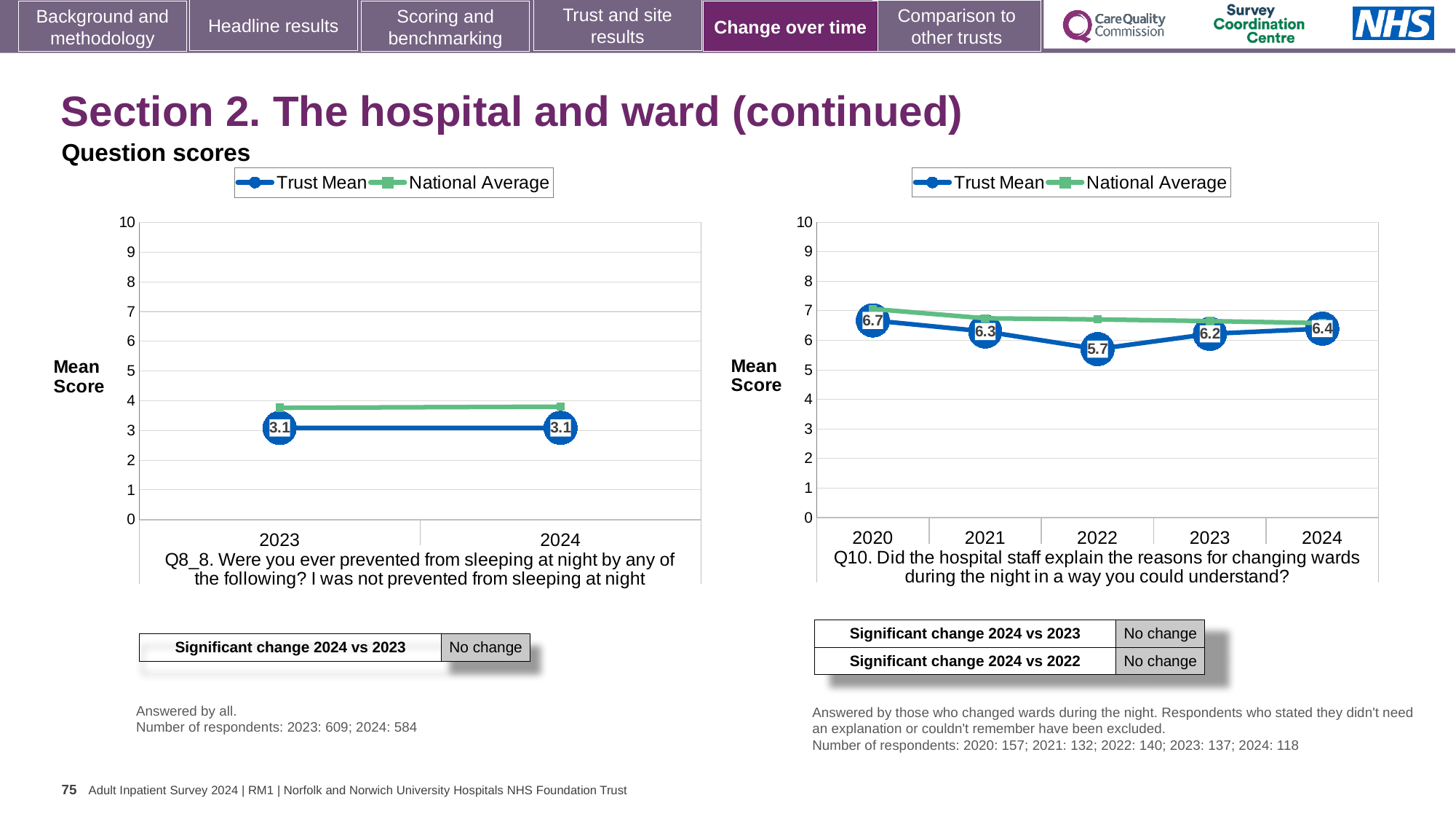
In the Q10 chart on the right, what is the difference between the Trust Mean scores for 2020 and 2022? 1.0 How many series does the legend of the Q8_8 chart on the left list? 2 In the Q8_8 chart on the left, is the National Average value for 2024 greater or less than 3? greater How many years are shown on the x axis of the Q10 chart on the right? 5 In the Q8_8 chart on the left, what is the Trust Mean score for 2023? 3.1 In the Q10 chart on the right, what is the Trust Mean score for 2022? 5.7 In the Q8_8 chart on the left, what is the Trust Mean score for 2024? 3.1 In the Q10 chart on the right, what is the Trust Mean score for 2024? 6.4 In the Q10 chart on the right, which year has the lowest Trust Mean score? 2022 What kind of chart is the Q10 chart on the right? Line chart In the Q10 chart on the right, is the Trust Mean score for 2021 or 2023 larger? 2021 In the Q10 chart on the right, which year has the highest Trust Mean score? 2020